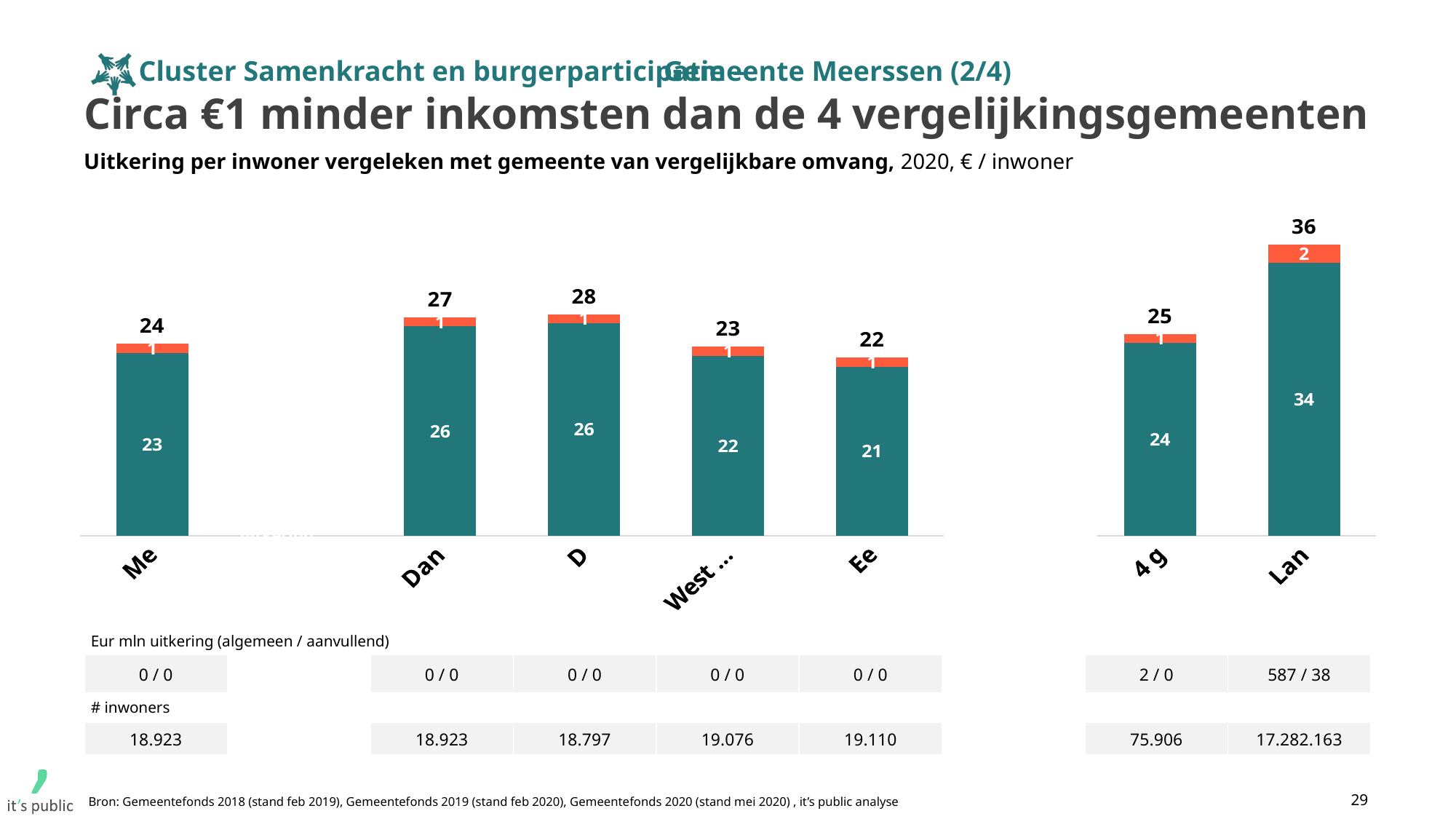
How many bars are shown in the chart? 7 What is the sum of the two segments of the bar for Dan? 27 What is the total value shown above the bar for Me? 24 What type of chart is shown on the slide? Stacked bar chart Which category has the highest total value? Lan Which has a larger total, Dan or West ...? Dan What is the difference between the total for D and the total for Ee? 6 What is the value of the teal (lower) segment of the bar for Lan? 34 Which category has the lowest total value? Ee What is the total value shown above the bar for 4 g? 25 What is the difference between the total for Lan and the total for Me? 12 What is the value of the orange (upper) segment of the bar for Lan? 2